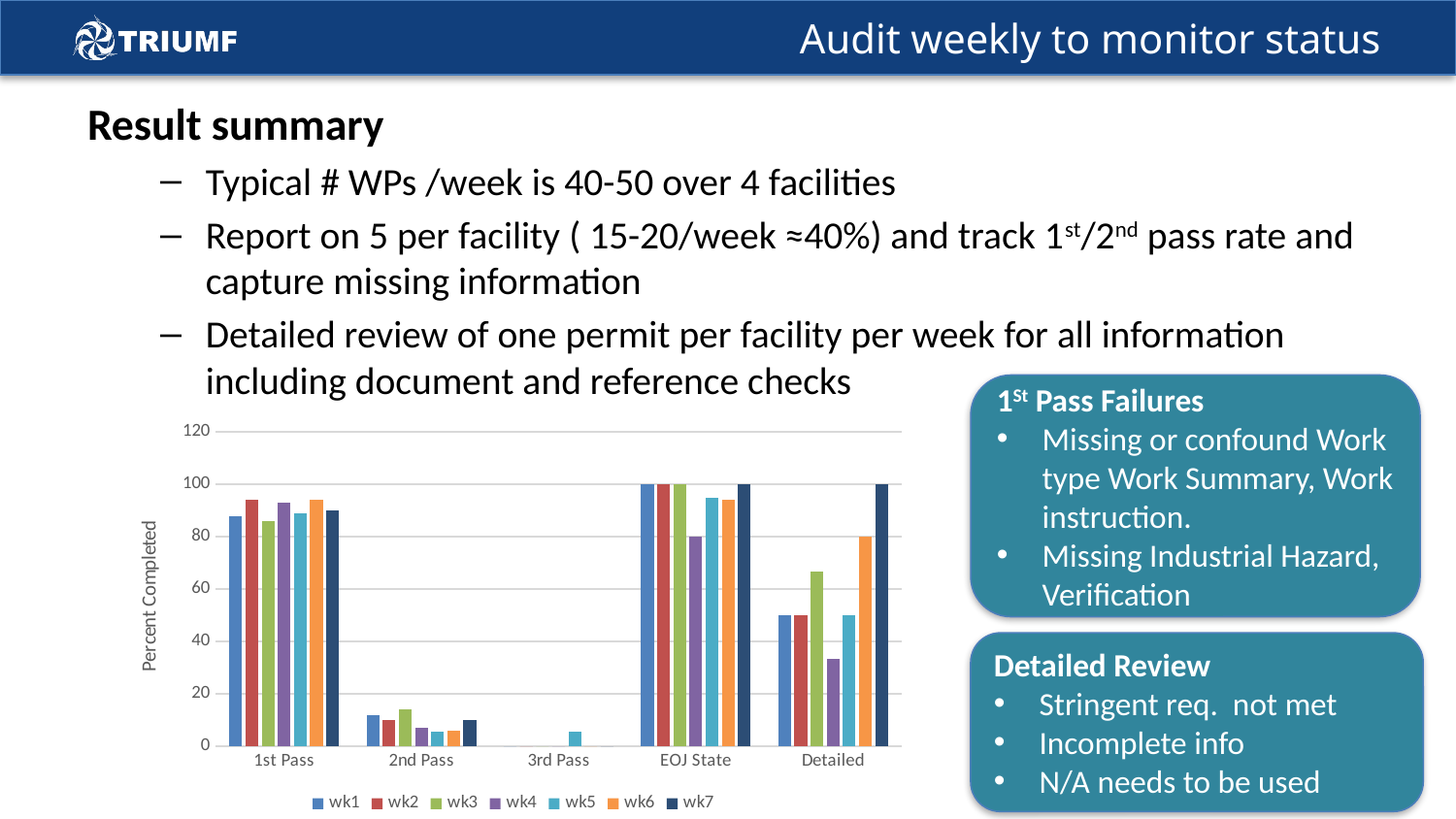
In the Detailed category, which week has the highest value? wk7 Is the value for wk1 in the 1st Pass category greater or less than 80? greater Is the value for wk4 in the Detailed category greater or less than 40? less What is the value for wk6 in the Detailed category? 80 Is the value for wk3 in the 2nd Pass category greater or less than 20? less What is the value for wk1 in the EOJ State category? 100 How many categories are shown along the x axis of the chart? 5 How many series does the chart's legend list? 7 What kind of chart is shown on the slide? bar chart In the Detailed category, which is larger, wk3 or wk4? wk3 Which category on the x axis has the lowest values overall? 3rd Pass What is the title of the chart's vertical axis? Percent Completed